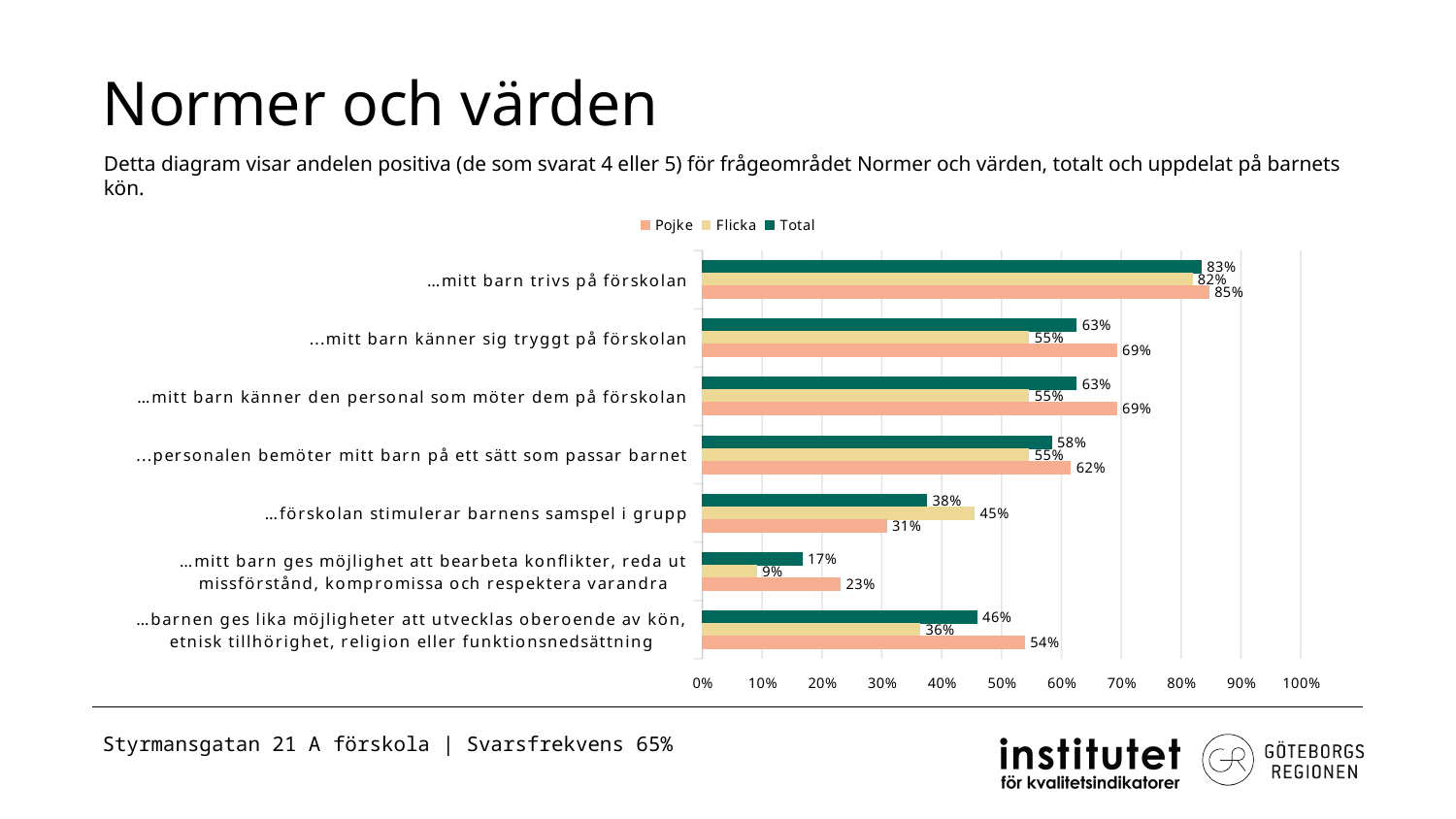
How many categories are shown on the chart? 7 Which category has the lowest Total value? …mitt barn ges möjlighet att bearbeta konflikter, reda ut missförstånd, kompromissa och respektera varandra What is the difference between the Pojke and Flicka values for "…barnen ges lika möjligheter att utvecklas oberoende av kön, etnisk tillhörighet, religion eller funktionsnedsättning"? 18 percentage points For "…förskolan stimulerar barnens samspel i grupp", which is larger, the Pojke value or the Flicka value? Flicka Which series is shown in dark green in the legend? Total What is the Total value for "…mitt barn trivs på förskolan"? 83% What is the Pojke value for "…mitt barn känner sig tryggt på förskolan"? 69% What is the Flicka value for "…förskolan stimulerar barnens samspel i grupp"? 45% How many series does the legend list? 3 Which category has the highest Pojke value? …mitt barn trivs på förskolan What is the Flicka value for "…mitt barn ges möjlighet att bearbeta konflikter, reda ut missförstånd, kompromissa och respektera varandra"? 9% What kind of chart is shown on the slide? Bar chart